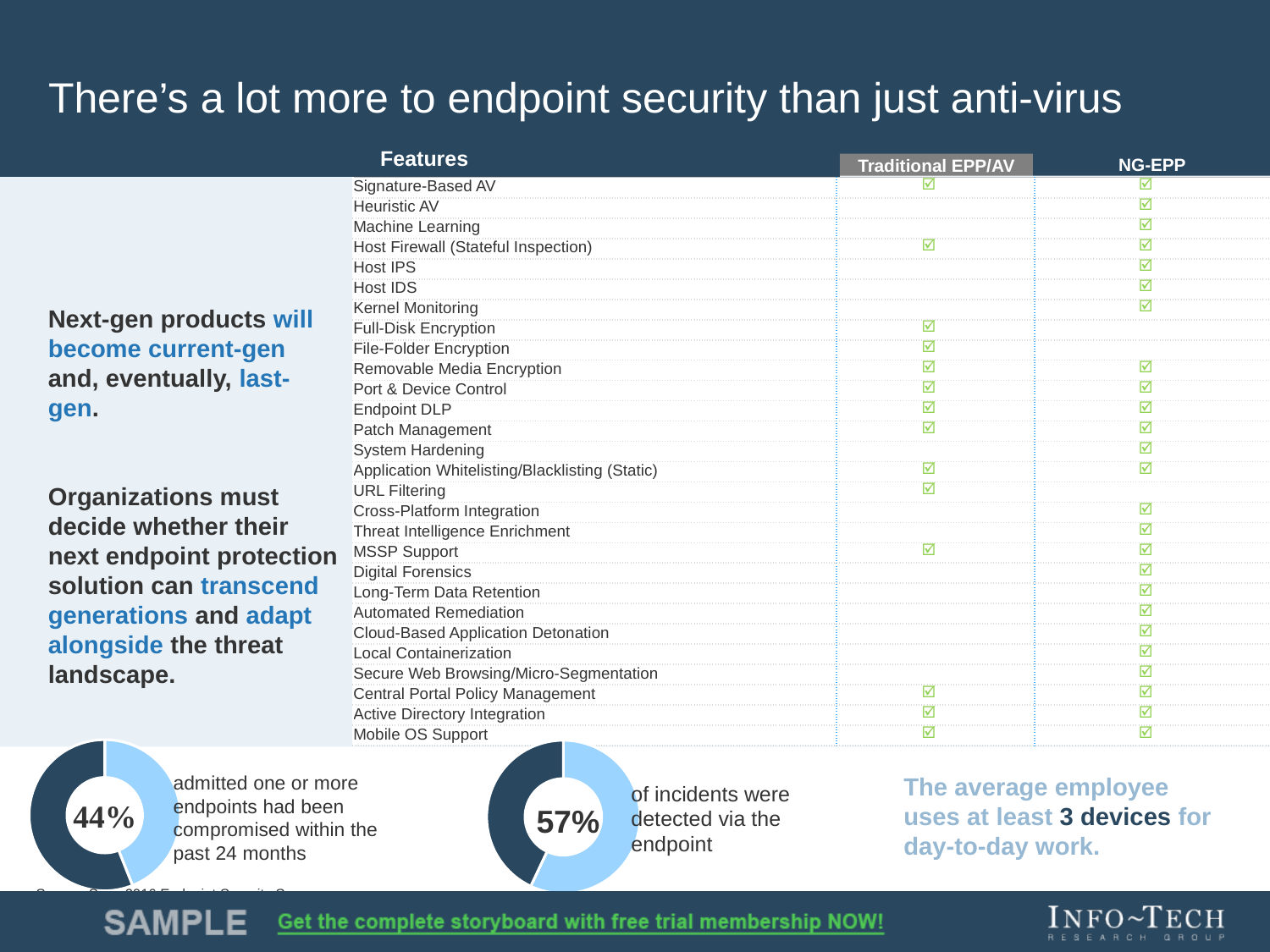
What kind of chart is used to show the 44% figure? Donut (pie) chart Is the value shown in the right donut chart greater or less than 50%? greater How many donut charts appear on the slide? 2 Is the value shown in the left donut chart greater or less than 50%? less What two colours are used in the donut charts? Dark blue and light blue What percentage is shown in the left donut chart at the bottom of the slide? 44% What is the difference in percentage points between the right donut chart (57%) and the left donut chart (44%)? 13 percentage points Which donut chart shows the larger percentage, the left one (44%) or the right one (57%)? The right one (57%) What percentage is shown in the right donut chart at the bottom of the slide? 57% According to the right donut chart, what share of incidents were detected via the endpoint? 57% According to the left donut chart, what share of respondents admitted one or more endpoints had been compromised within the past 24 months? 44% What does the 57% in the right donut chart represent? Incidents that were detected via the endpoint